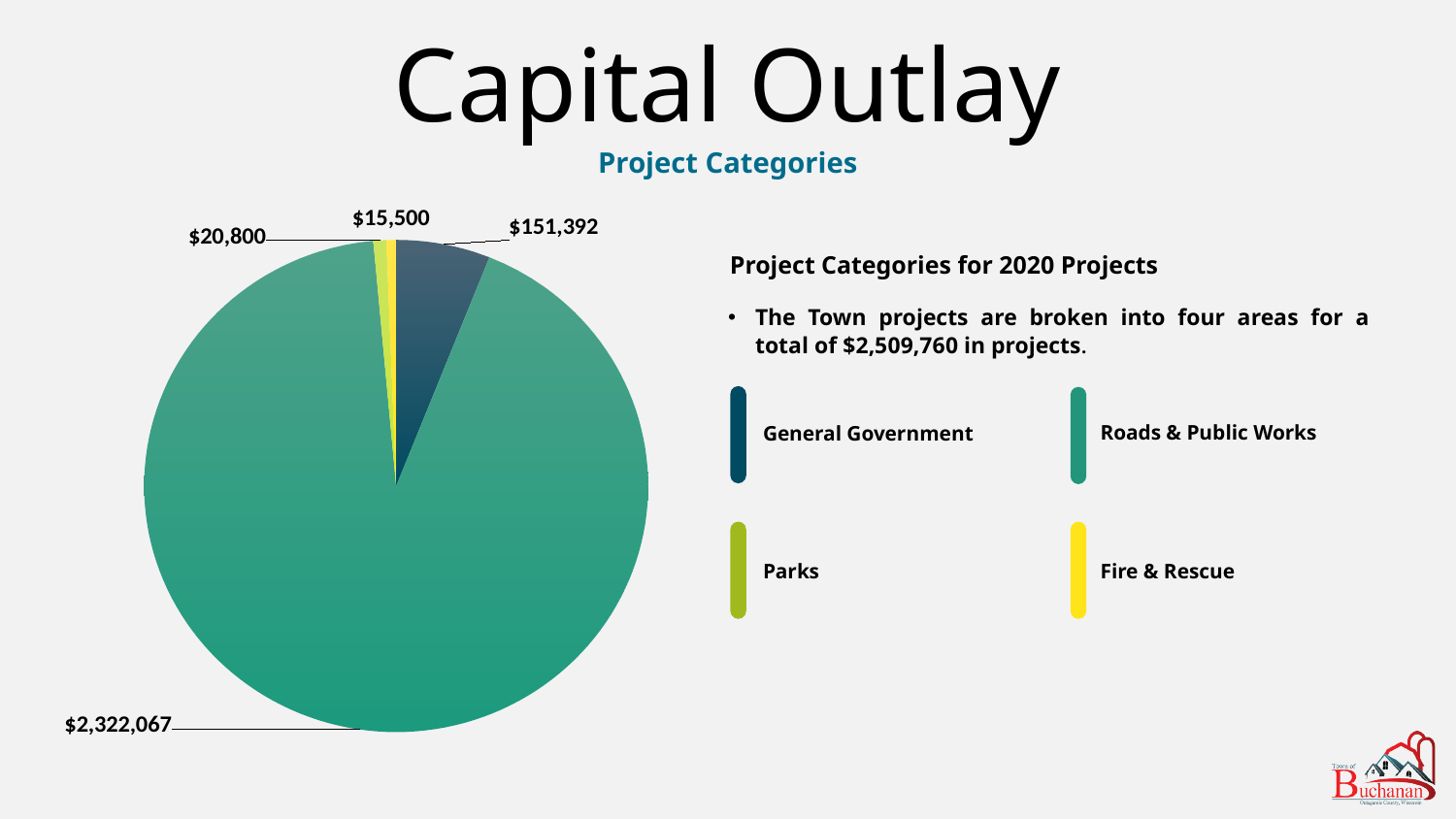
Which category has the largest slice in the pie chart? Roads & Public Works What is the difference between the Parks value and the Fire & Rescue value? $5,300 What is the value of the Fire & Rescue slice in the pie chart? $15,500 Which is larger, the General Government slice or the Fire & Rescue slice? General Government What is the difference between the General Government value and the Parks value? $130,592 How many slices does the pie chart have? 4 What is the value of the Parks slice in the pie chart? $20,800 What kind of chart is shown on the slide? pie chart What is the value of the General Government slice in the pie chart? $151,392 What is the subtitle of the pie chart shown under the slide title? Project Categories Which category has the smallest slice in the pie chart? Fire & Rescue What is the value of the Roads & Public Works slice in the pie chart? $2,322,067